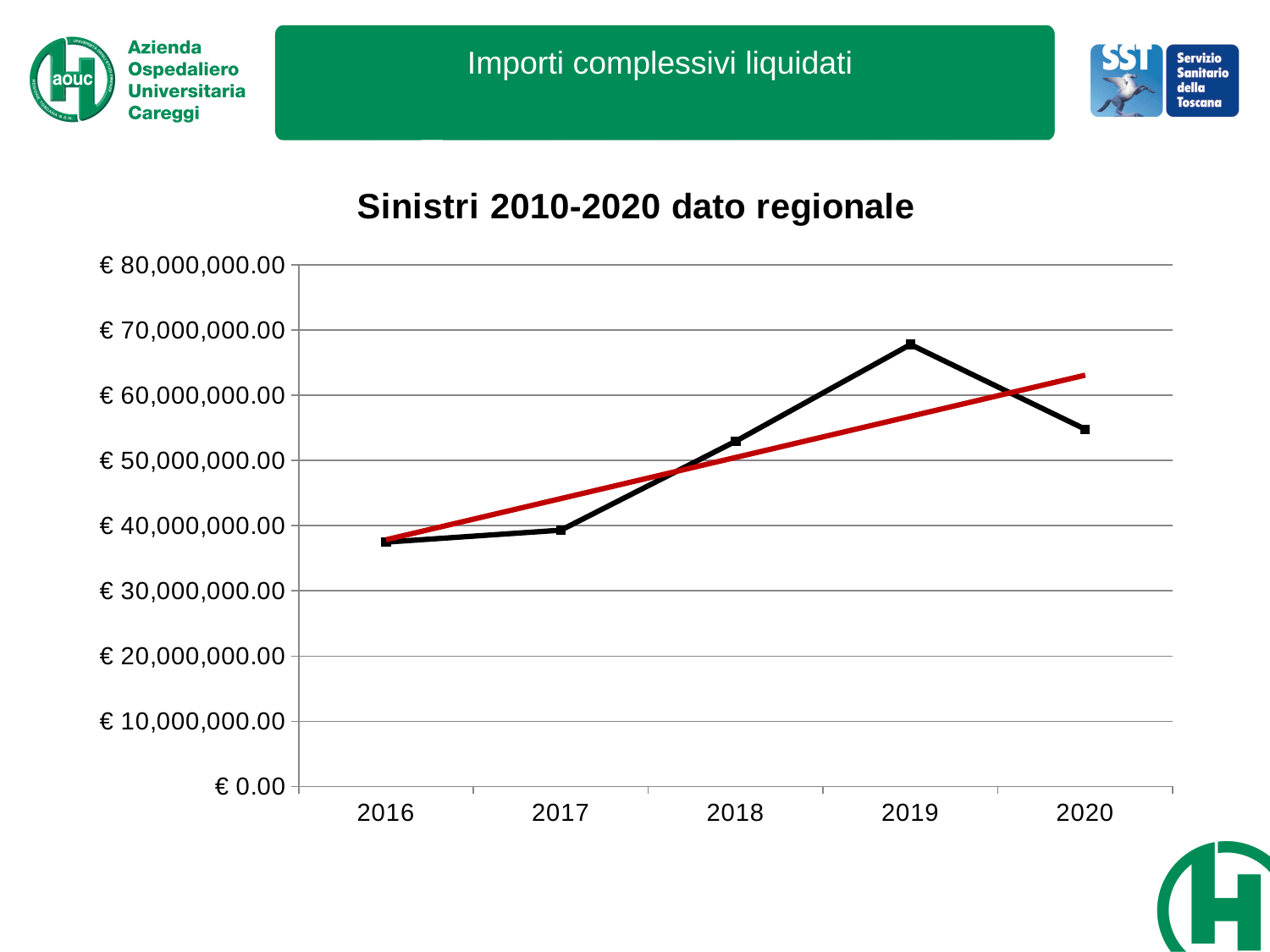
Which year has the lowest value on the black line? 2016 Do the values on the black line rise or fall from 2016 to 2019? rise Which year has the highest value on the black line? 2019 Which year has the larger value, 2019 or 2020? 2019 Is the value for 2020 greater or less than € 60,000,000.00? less What kind of chart is shown on the slide? Line chart What is the title of the chart? Sinistri 2010-2020 dato regionale Is the value for 2016 greater or less than € 40,000,000.00? less Is the value for 2018 greater or less than € 50,000,000.00? greater What is the highest value shown on the y axis of the chart? € 80,000,000.00 How many years are plotted on the x axis of the chart? 5